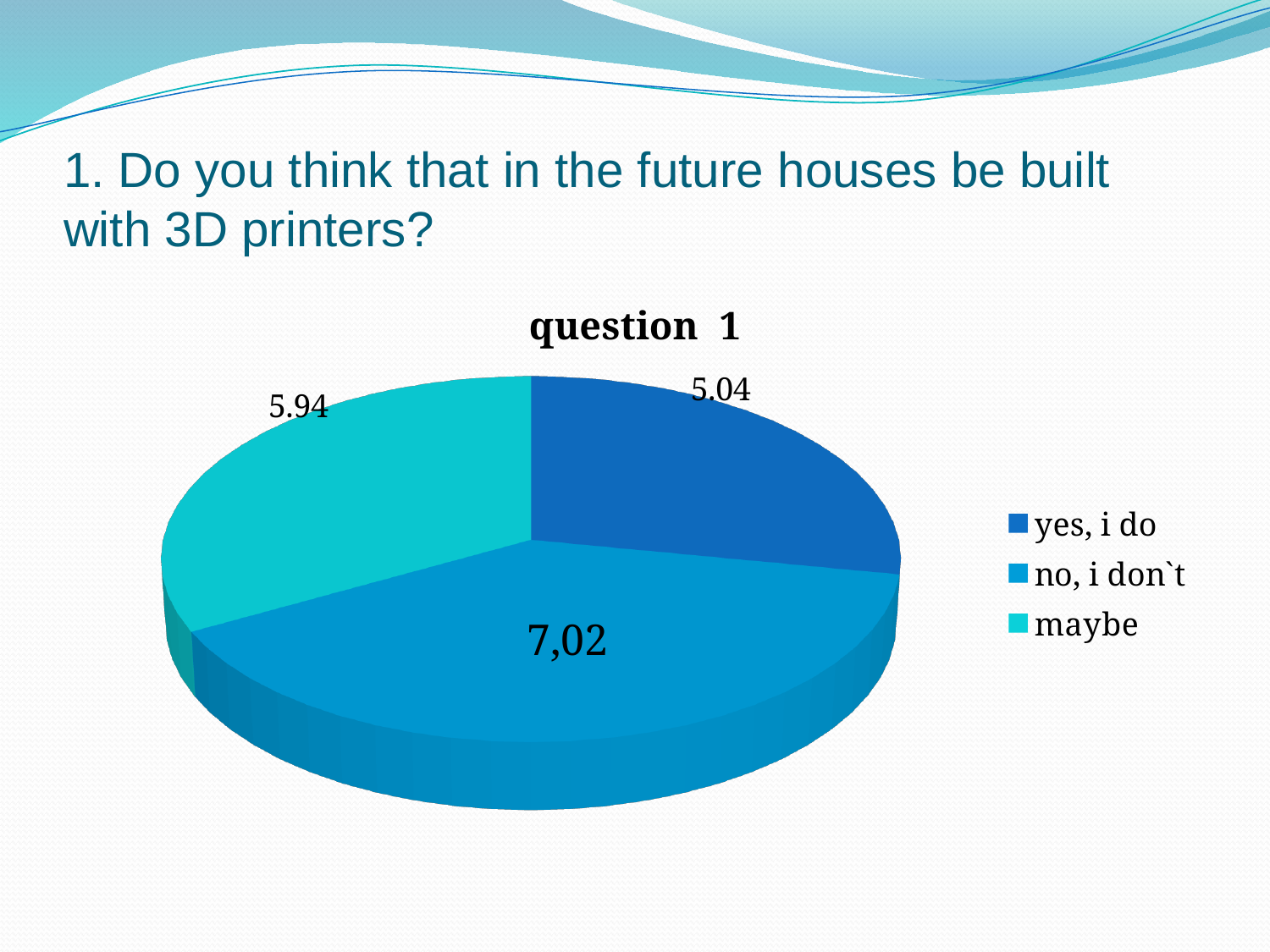
How many entries does the legend list? 3 What type of chart is shown on the slide? pie chart What share of the pie does the "no, i don`t" slice represent? 39% What is the difference between the value for "no, i don`t" and the value for "yes, i do"? 1.98 Which category has the smallest slice of the pie? yes, i do Which is larger, the value for "maybe" or the value for "yes, i do"? maybe Which category has the largest slice of the pie? no, i don`t What is the chart's title? question 1 What is the value for the "no, i don`t" slice? 7,02 How many categories does the pie chart have? 3 What is the value for the "maybe" slice? 5.94 What is the value for the "yes, i do" slice? 5.04